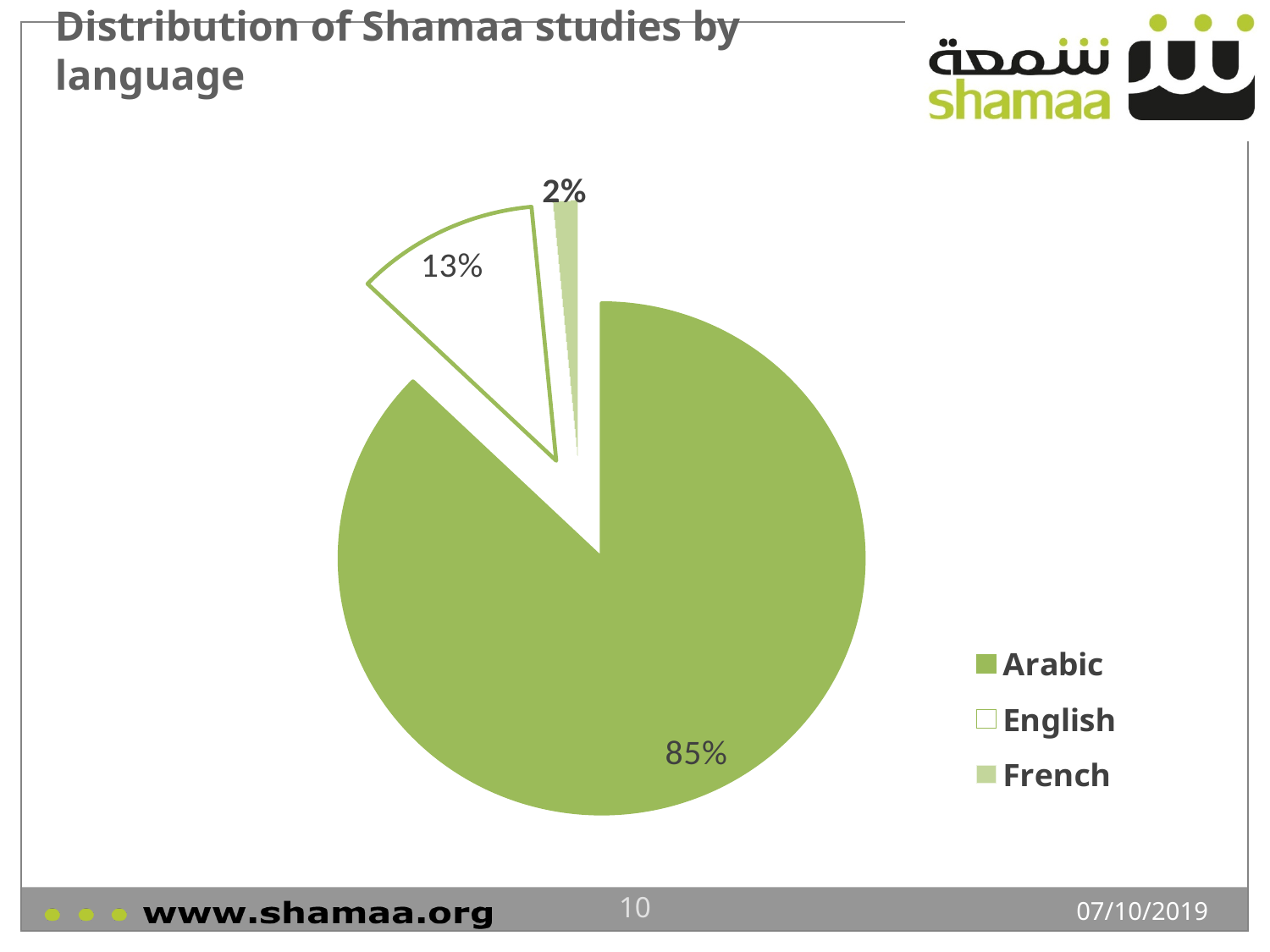
What share of Shamaa studies are in French? 2% What kind of chart is shown on the slide? Pie chart Which language has the smallest share of Shamaa studies? French Which has a larger share, English or French? English What share of Shamaa studies are in English? 13% Which language has the largest share of Shamaa studies? Arabic How many languages are shown in the pie chart? 3 What is the difference in percentage points between the English and French shares? 11 Which legend entry is shown with a white (unfilled) marker? English What share of Shamaa studies are in Arabic? 85% What is the title of the chart on the slide? Distribution of Shamaa studies by language What is the difference in percentage points between the Arabic and English shares? 72